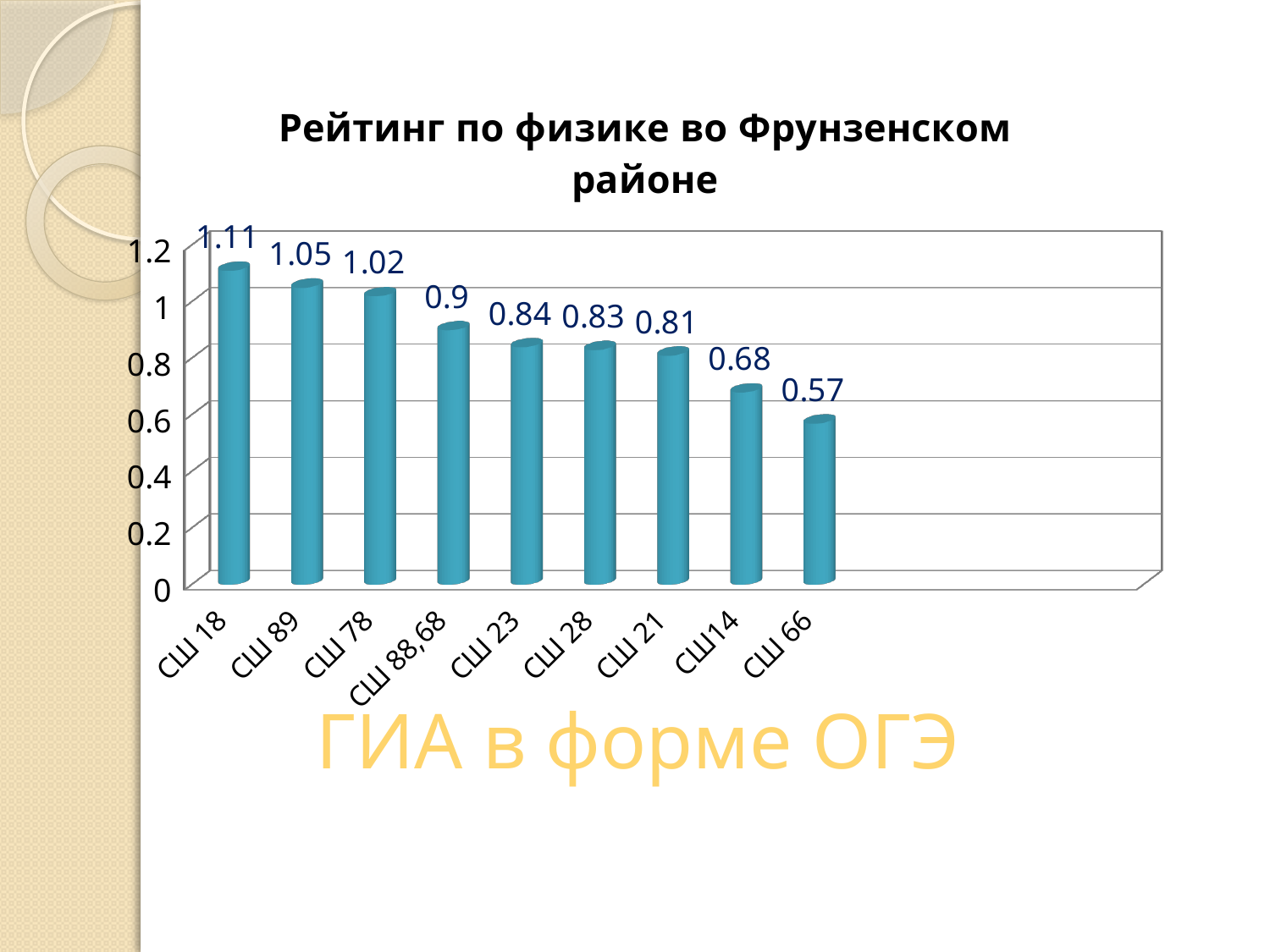
What is the difference between the values for СШ 89 and СШ14? 0.37 How many categories are shown in the chart? 9 What is the value for СШ 18? 1.11 What is the value for СШ 21? 0.81 Which is larger, the value for СШ 78 or the value for СШ 23? СШ 78 Which category has the lowest value? СШ 66 What is the value for СШ 88,68? 0.9 Do the values rise or fall from left to right along the x axis? fall Which category has the highest value? СШ 18 What is the difference between the values for СШ 18 and СШ 66? 0.54 What kind of chart is shown on the slide? bar chart Is the value for СШ 66 greater or less than 0.6? less